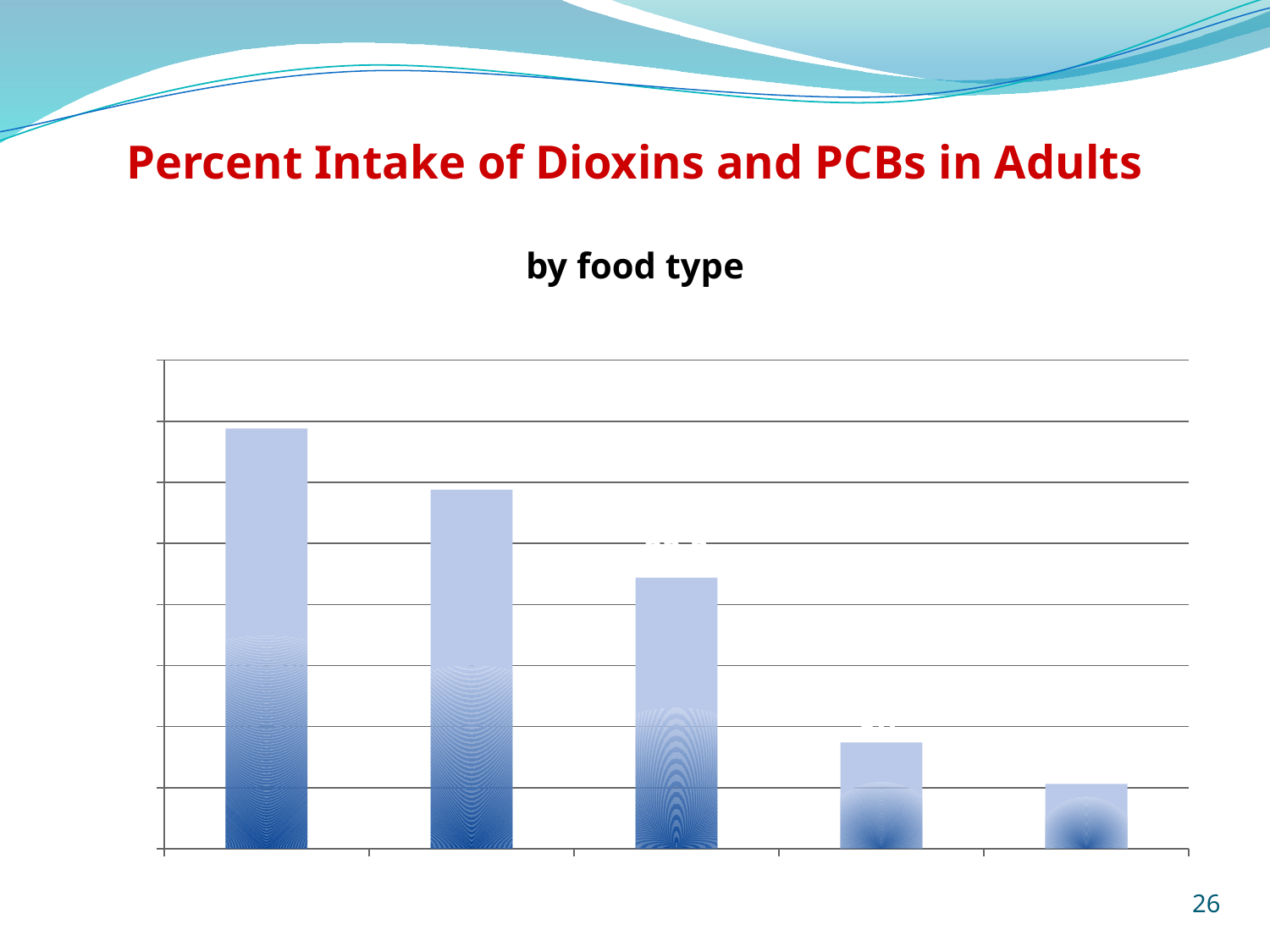
Do the bar values rise or fall from left to right across the chart? fall How many bars are plotted in the chart? 5 What kind of chart is shown on the slide? bar chart What is the title of the slide containing the chart? Percent Intake of Dioxins and PCBs in Adults Which bar is the shortest in the chart, counting from the left? the fifth bar Is the fourth bar from the left taller or shorter than the fifth bar from the left? taller Which bar is the tallest in the chart, counting from the left? the first bar According to the subtitle, by what are the percent intakes broken down? by food type Is the first bar from the left taller or shorter than the fourth bar from the left? taller Is the second bar from the left taller or shorter than the third bar from the left? taller